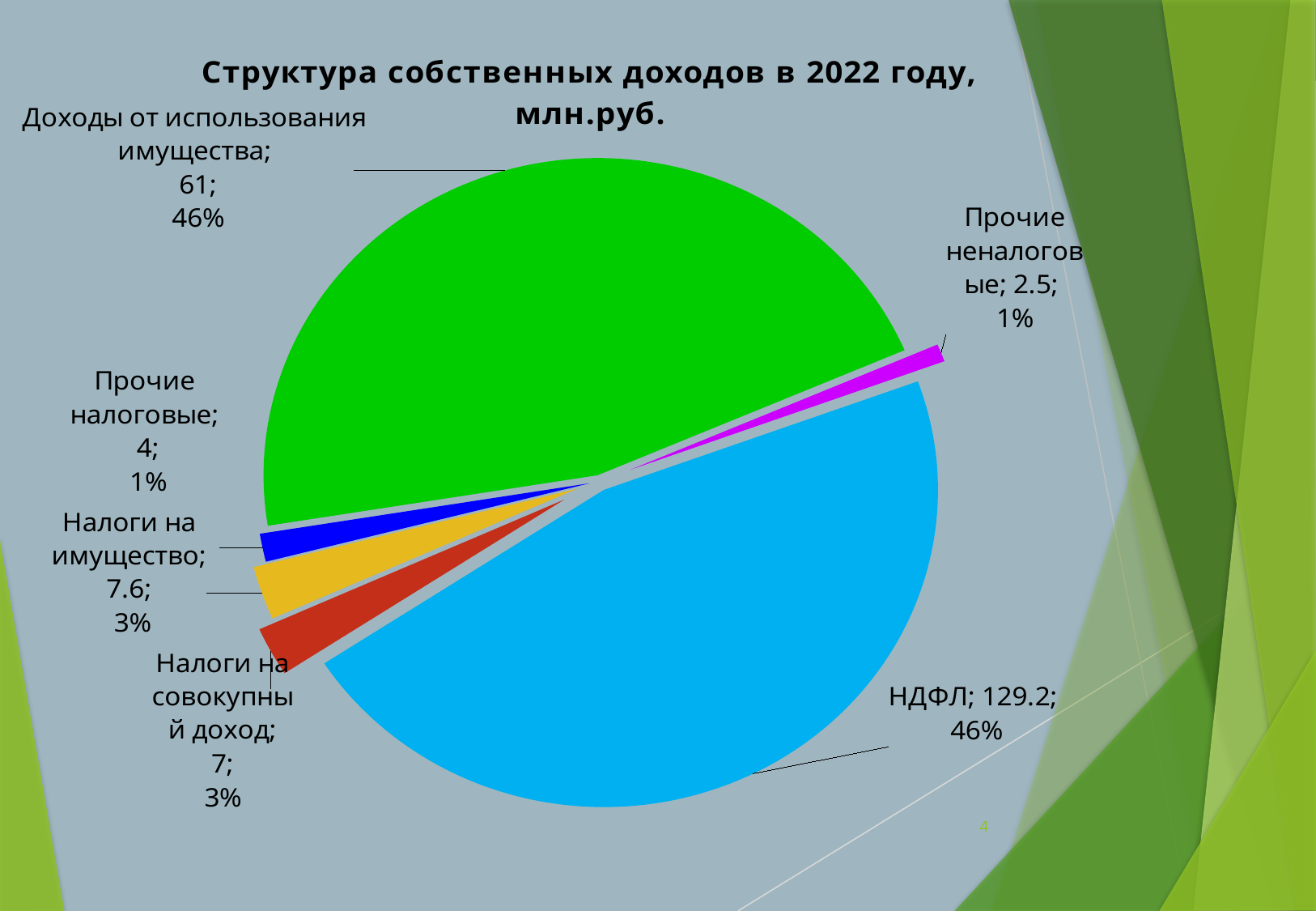
How many slices does the pie chart have? 6 What is the value for Доходы от использования имущества? 61 Which is larger, the value for Налоги на имущество or the value for Налоги на совокупный доход? Налоги на имущество What is the title of the chart? Структура собственных доходов в 2022 году, млн.руб. What is the difference between the values for НДФЛ and Доходы от использования имущества? 68.2 Which category has the smallest value? Прочие неналоговые Which category has the largest value? НДФЛ What kind of chart is shown on the slide? Pie chart What is the value for НДФЛ? 129.2 What share of the pie is labelled for Прочие налоговые? 1% What is the value for Налоги на имущество? 7.6 What is the value for Прочие неналоговые? 2.5